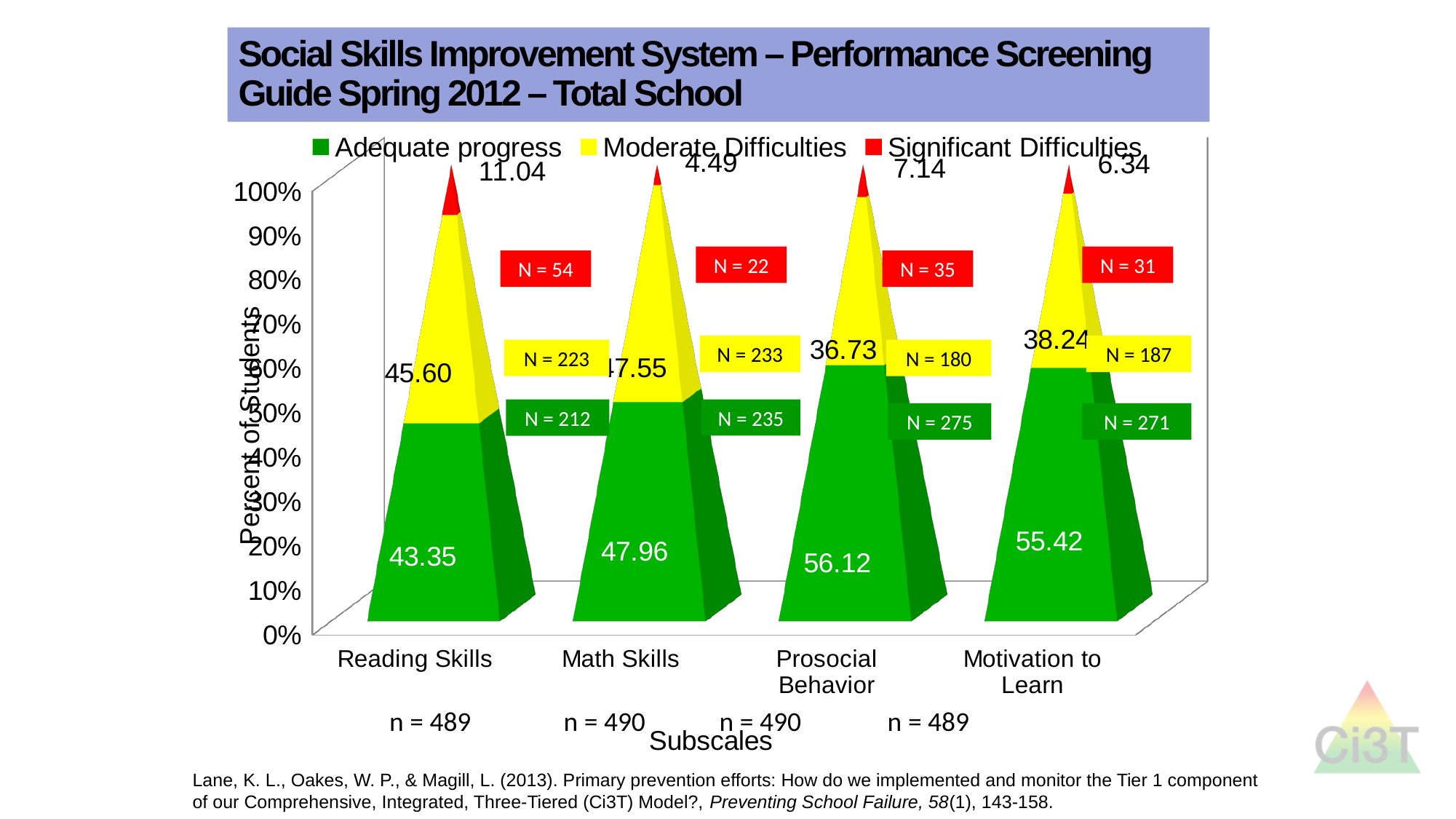
How many subscales are shown on the x axis? 4 What is the Moderate Difficulties value for Motivation to Learn? 38.24 What is the title of the y axis? Percent of Students Which has a larger Adequate progress value, Reading Skills or Math Skills? Math Skills What is the Significant Difficulties value for Reading Skills? 11.04 What is the difference between the Significant Difficulties values for Reading Skills and Math Skills? 6.55 How many series does the legend list? 3 What kind of chart is shown on the slide? stacked bar chart Which subscale has the highest Adequate progress value? Prosocial Behavior What is the Adequate progress value for Prosocial Behavior? 56.12 Which subscale has the lowest Significant Difficulties value? Math Skills What is the Adequate progress value for Math Skills? 47.96